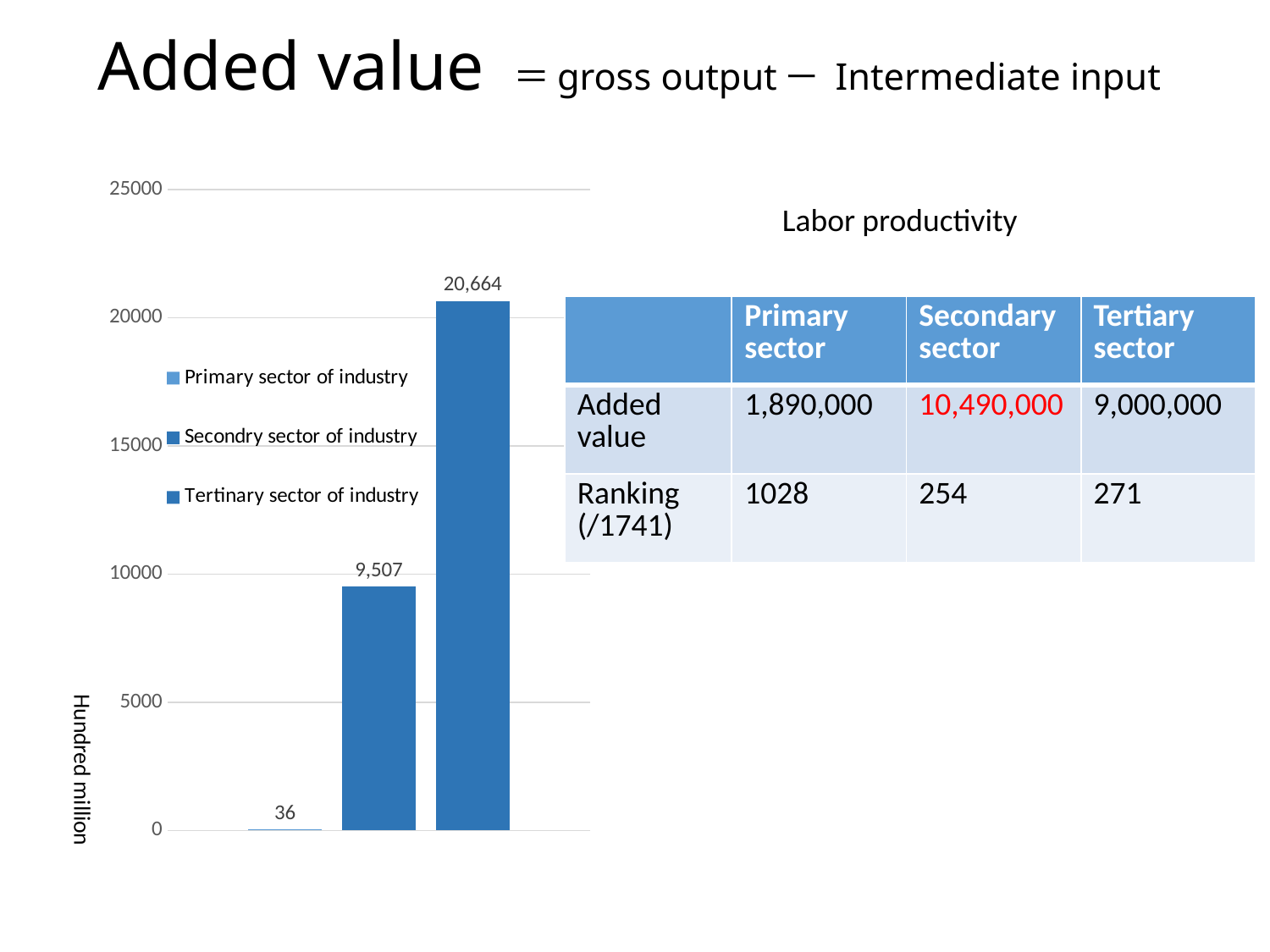
What is the value for the Tertinary sector of industry in the bar chart? 20,664 What unit is given on the vertical axis label of the bar chart? Hundred million What kind of chart is shown on the slide? bar chart Which is larger in the bar chart, the Secondry sector of industry or the Primary sector of industry? Secondry sector of industry Which sector has the lowest value in the bar chart? Primary sector of industry What is the difference between the Secondry sector and the Primary sector values in the bar chart? 9,471 Which sector has the highest value in the bar chart? Tertinary sector of industry What is the value for the Secondry sector of industry in the bar chart? 9,507 What is the value for the Primary sector of industry in the bar chart? 36 How many series does the legend of the bar chart list? 3 What is the difference between the Tertinary sector and the Secondry sector values in the bar chart? 11,157 Is the value for the Tertinary sector of industry greater or less than 20000? greater